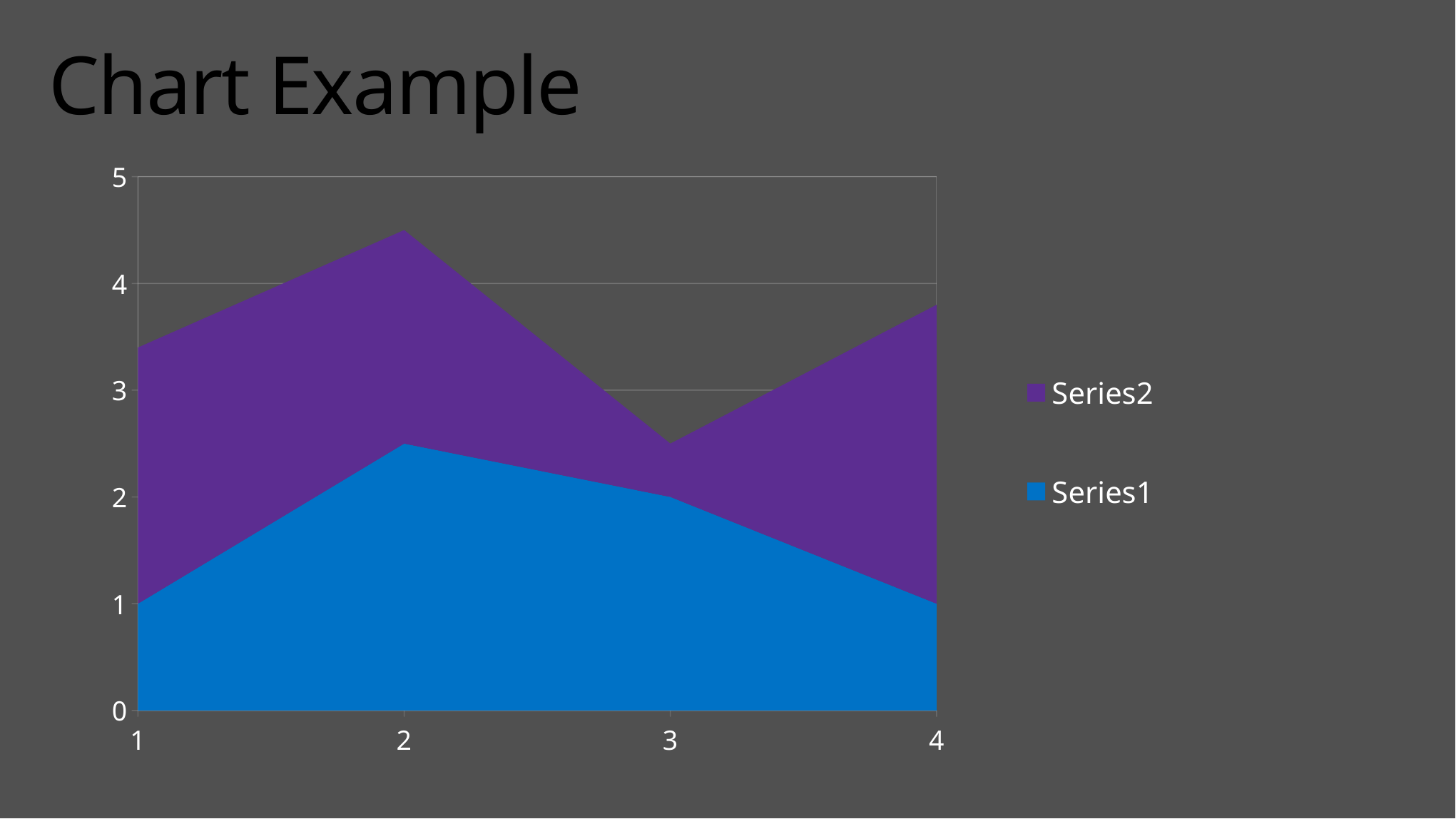
What kind of chart is shown on the slide? Area chart What is the value of Series1 at category 1? 1 Does Series1 rise or fall from category 2 to category 4? Fall What is the title of the slide? Chart Example What is the value of Series1 at category 4? 1 Is the stacked total at category 2 greater or less than 4? greater How many categories are shown along the x axis? 4 How many series does the legend list? 2 Is the stacked total at category 3 greater or less than 3? less At which category does Series1 reach its highest value? 2 What is the value of Series1 at category 3? 2 Is the value of Series1 at category 2 greater or less than 2? greater